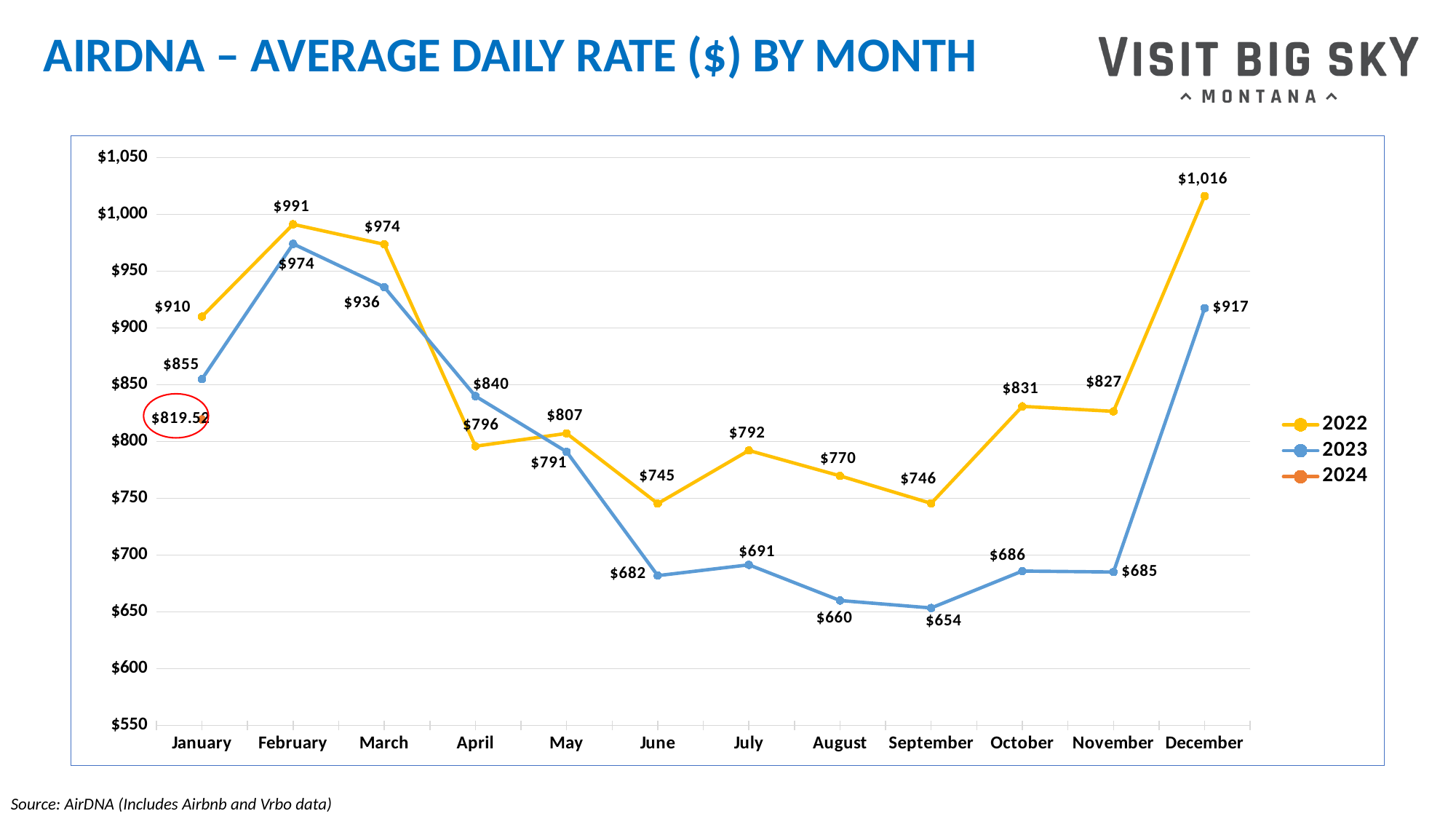
How many series does the legend list? 3 Which month has the lowest 2023 average daily rate? September Does the 2023 average daily rate rise or fall from February to September? fall Is the 2023 average daily rate for June greater or less than $700? less What kind of chart is shown on the slide? line chart Which is larger, the 2022 or the 2023 average daily rate for April? 2023 What is the 2022 average daily rate for December? $1,016 What is the difference between the 2022 and 2023 average daily rates for December? $99 Which month has the highest 2022 average daily rate? December What is the 2024 average daily rate for January? $819.52 What is the 2023 average daily rate for September? $654 How many months are shown on the x axis? 12